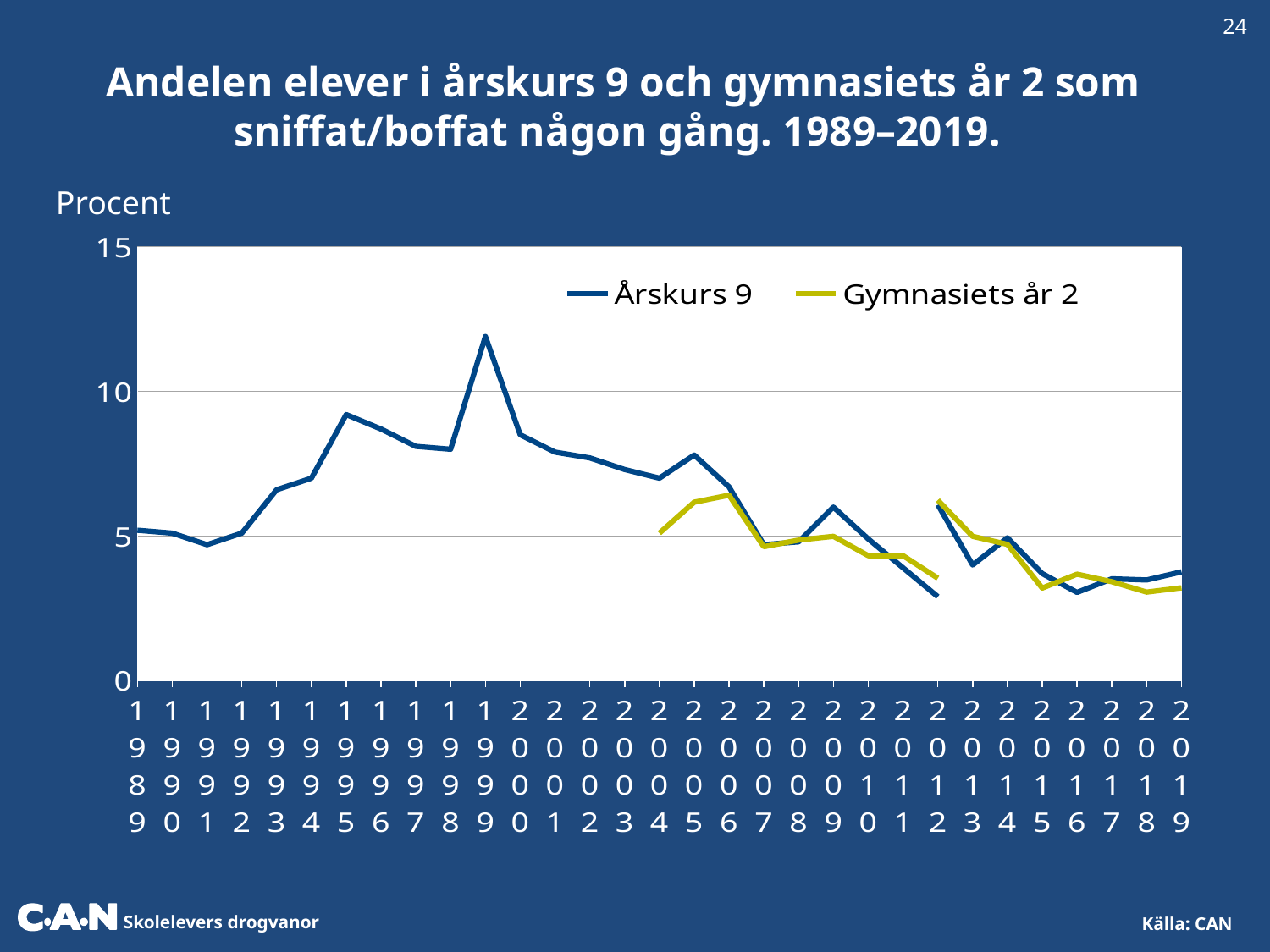
How many years are shown along the x axis? 31 Is the value for Gymnasiets år 2 in 2018 greater or less than 5? less Which two series are listed in the legend? Årskurs 9 and Gymnasiets år 2 How many series does the legend list? 2 Is the value for Årskurs 9 in 1995 greater or less than 5? greater Which series has the larger value in 2005, Årskurs 9 or Gymnasiets år 2? Årskurs 9 Is the value for Årskurs 9 in 2019 greater or less than 5? less Does the Årskurs 9 series rise or fall between 1999 and 2012? Fall What is the label on the vertical axis? Procent In which year does the Årskurs 9 series reach its highest value? 1999 What kind of chart is shown on the slide? Line chart